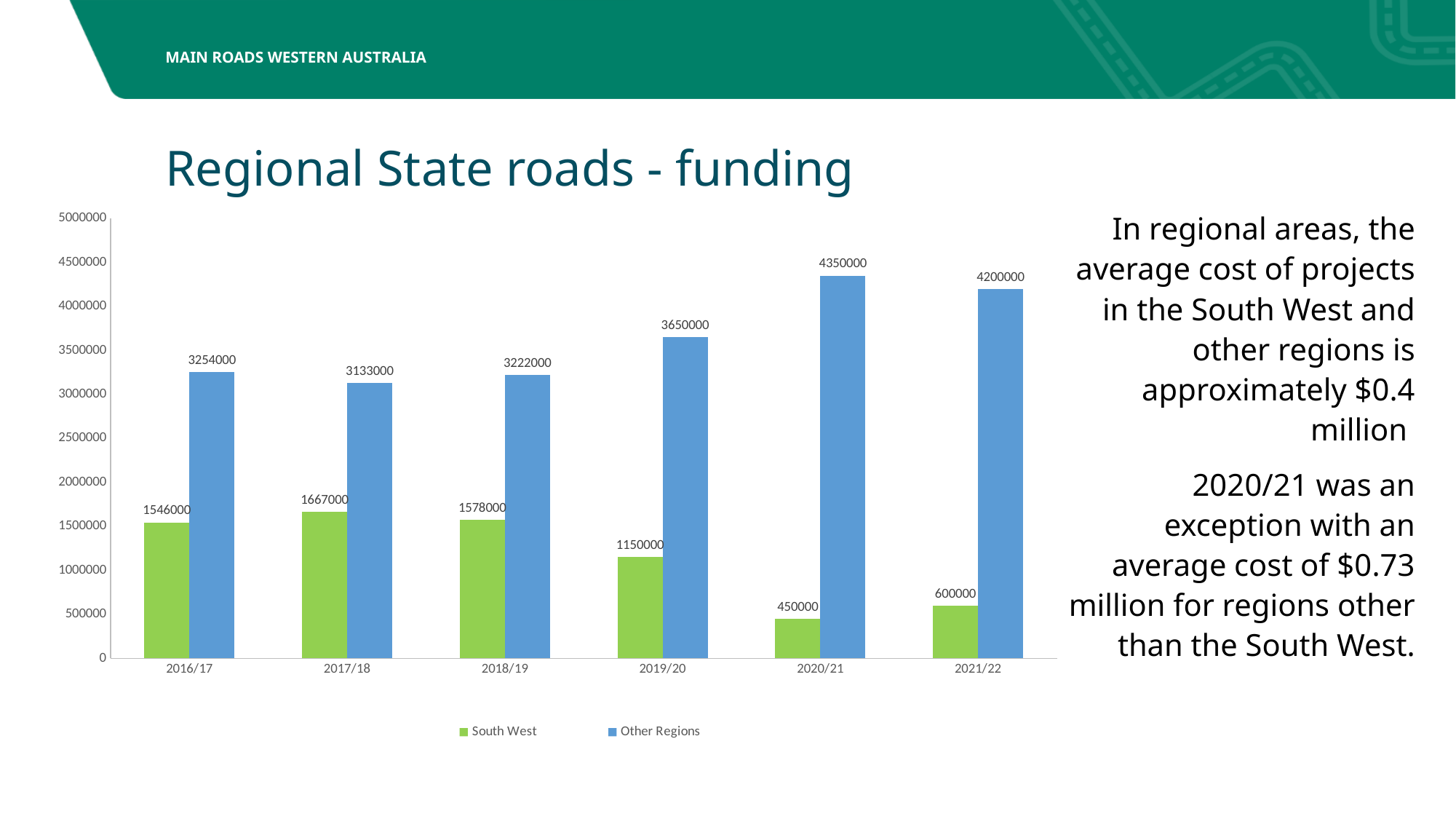
Is the Other Regions value for 2018/19 greater or less than 3000000? greater Which is larger in 2017/18: South West or Other Regions? Other Regions How many years are shown on the x axis? 6 Which year has the lowest South West value? 2020/21 How many series does the legend list? 2 What is the South West funding value for 2016/17? 1546000 What is the South West funding value for 2021/22? 600000 What is the Other Regions funding value for 2020/21? 4350000 What is the difference between the Other Regions and South West values in 2019/20? 2500000 Which year has the highest Other Regions value? 2020/21 Does the South West value rise or fall from 2018/19 to 2020/21? Fall What kind of chart is shown on the slide? Bar chart